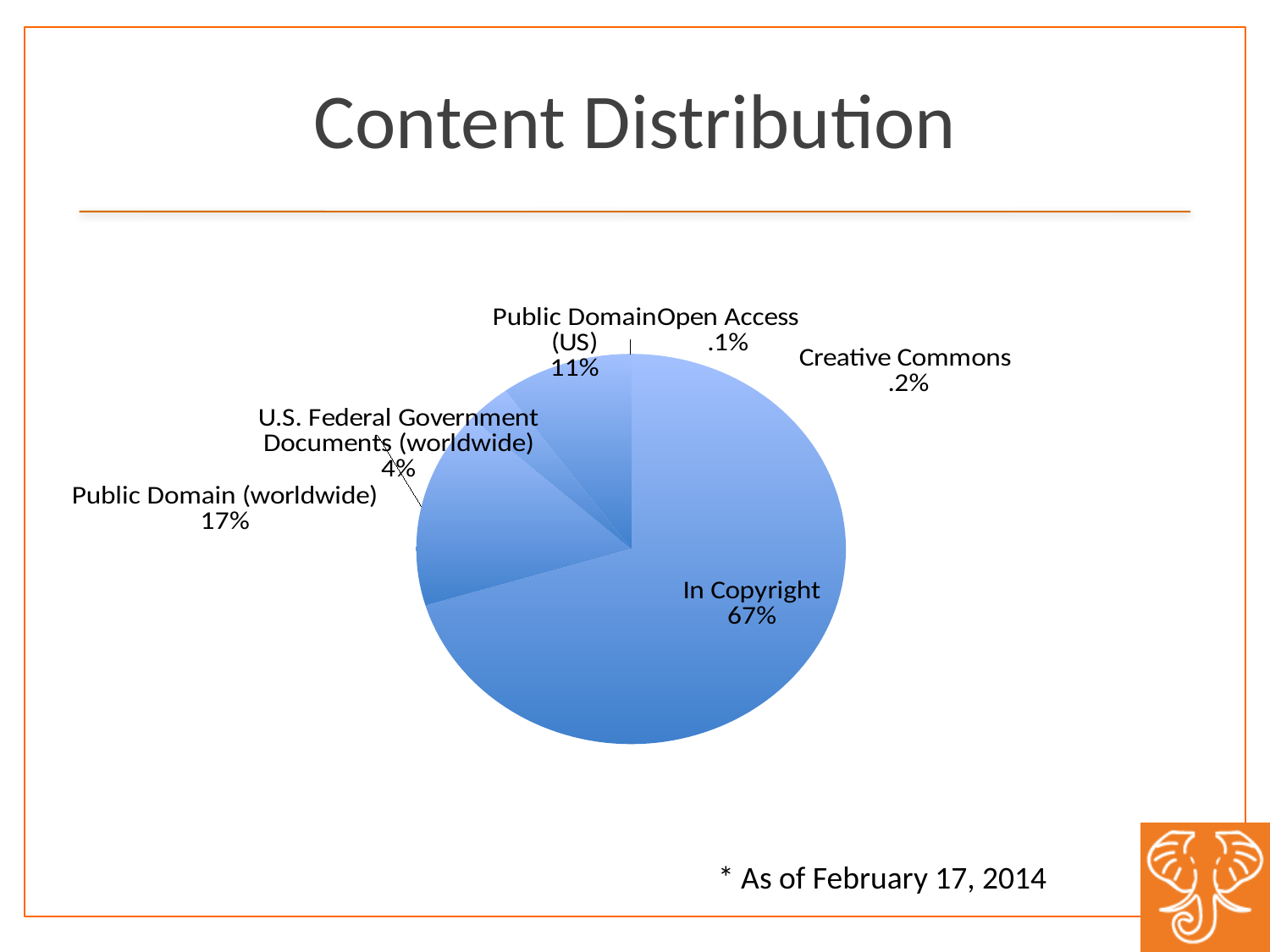
What kind of chart is shown on the slide? pie chart What share of the pie is Creative Commons? .2% What share of the pie is Open Access? .1% What share of the pie is In Copyright? 67% Which category has the smallest slice of the pie? Open Access What is the difference in percentage points between In Copyright and Public Domain (worldwide)? 50 What share of the pie is Public Domain (US)? 11% What share of the pie is Public Domain (worldwide)? 17% What is the title of the chart on the slide? Content Distribution Which category has the largest slice of the pie? In Copyright How many slices does the pie chart have? 6 What share of the pie is U.S. Federal Government Documents (worldwide)? 4%